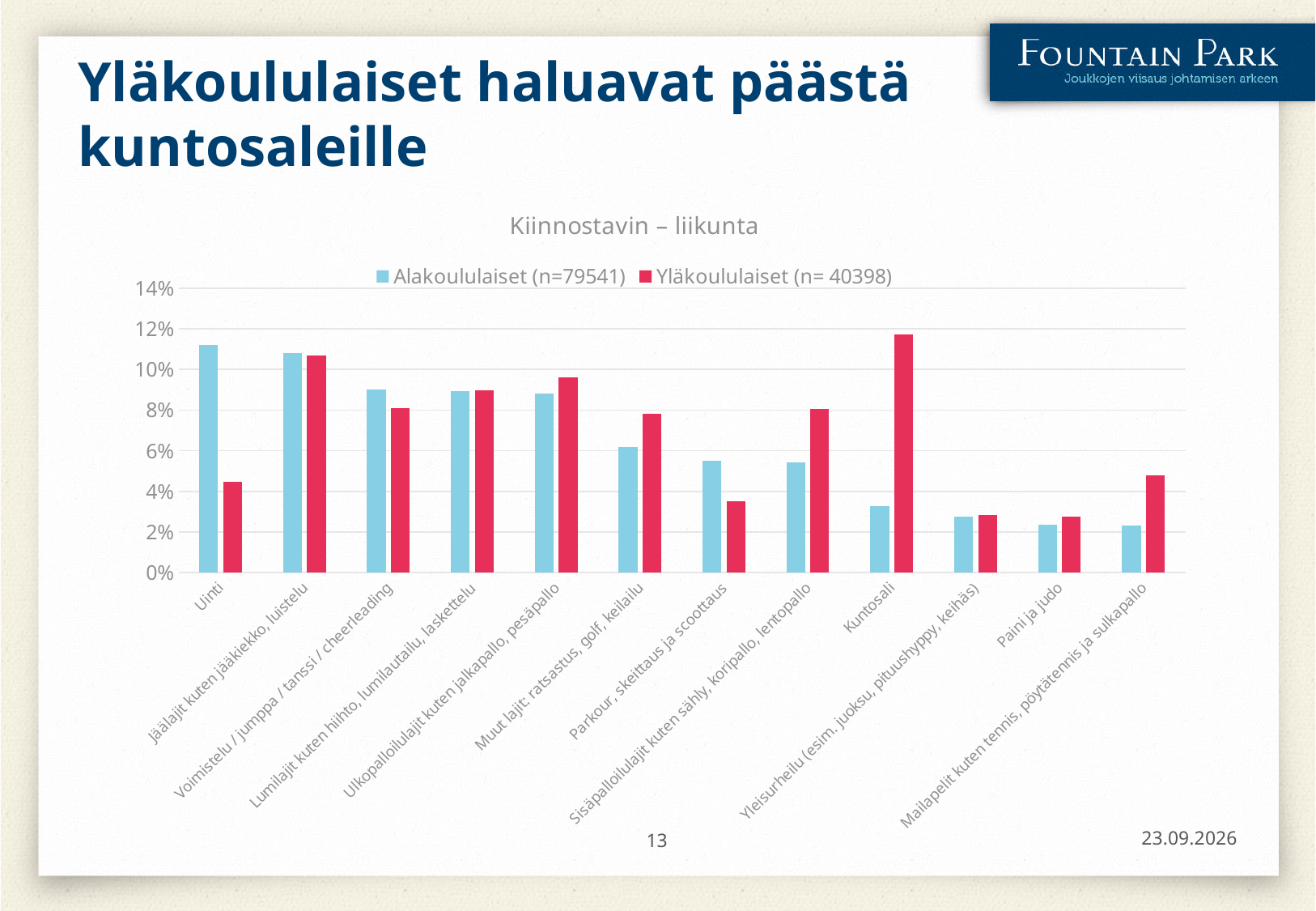
Which category has the highest value for Yläkoululaiset? Kuntosali How many sport categories are shown on the x axis? 12 What is the title of the chart? Kiinnostavin – liikunta Is the Yläkoululaiset value for Kuntosali greater or less than 10%? greater Which category has the highest value for Alakoululaiset? Uinti For Uinti, which series has the larger value, Alakoululaiset or Yläkoululaiset? Alakoululaiset For Sisäpalloilulajit kuten sähly, koripallo, lentopallo, which series has the larger value, Alakoululaiset or Yläkoululaiset? Yläkoululaiset Is the Alakoululaiset value for Kuntosali greater or less than 4%? less Is the Yläkoululaiset value for Uinti greater or less than 6%? less What kind of chart is shown on the slide? Bar chart How many series does the legend list? 2